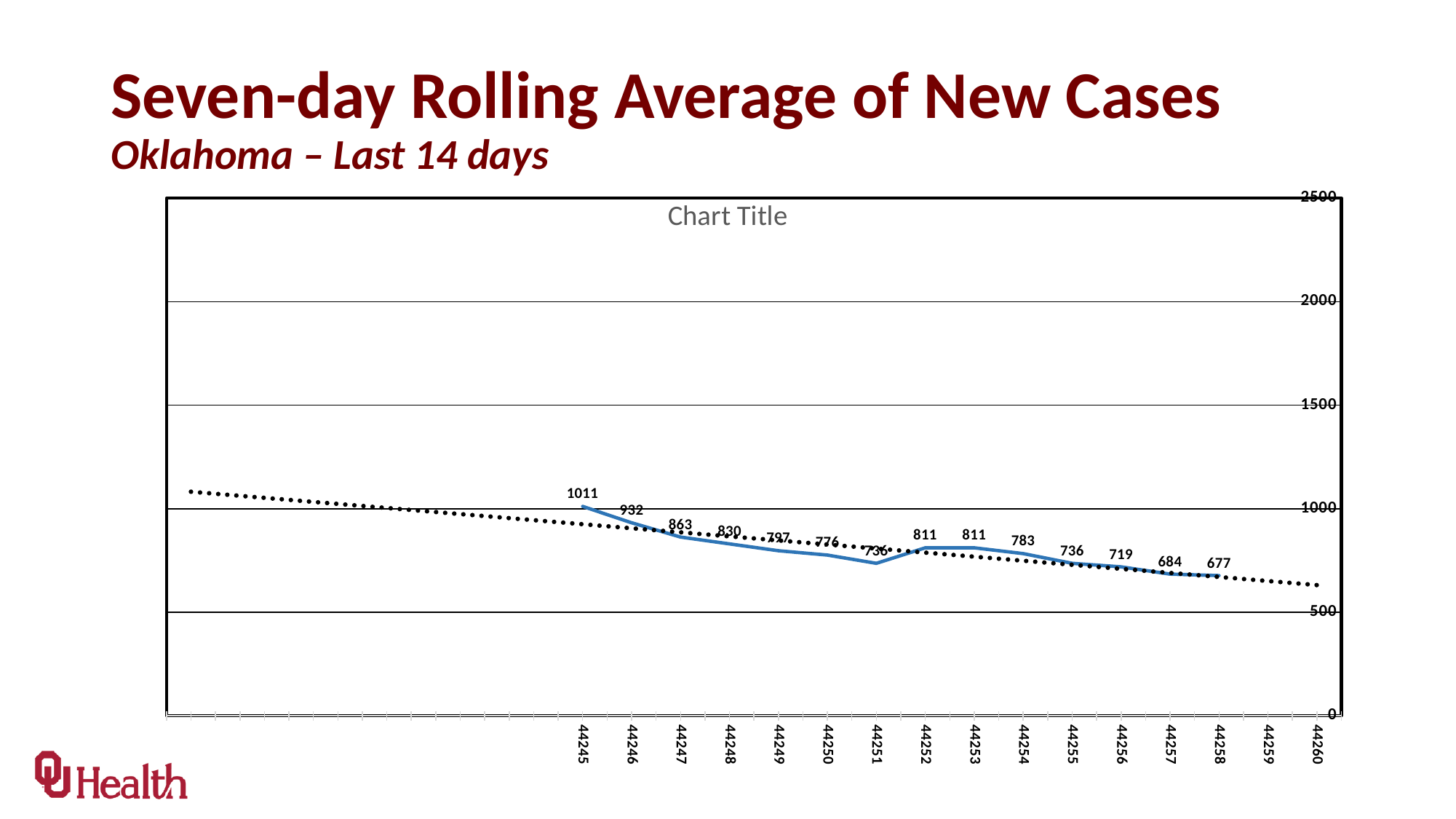
Which x-axis point has the highest labelled value? 44245 What is the difference between the values at 44245 and 44246? 79 Which x-axis point has the lowest labelled value? 44258 What is the value labelled at 44254? 783 What is the title shown inside the chart area? Chart Title What is the value labelled at 44258? 677 What kind of chart is shown on the slide? line chart Overall, do the labelled values rise or fall from 44245 to 44258? fall Which is larger, the value at 44252 or the value at 44251? 44252 How many data points on the solid line have value labels? 14 What is the value labelled at 44251? 736 What is the value labelled at 44245? 1011